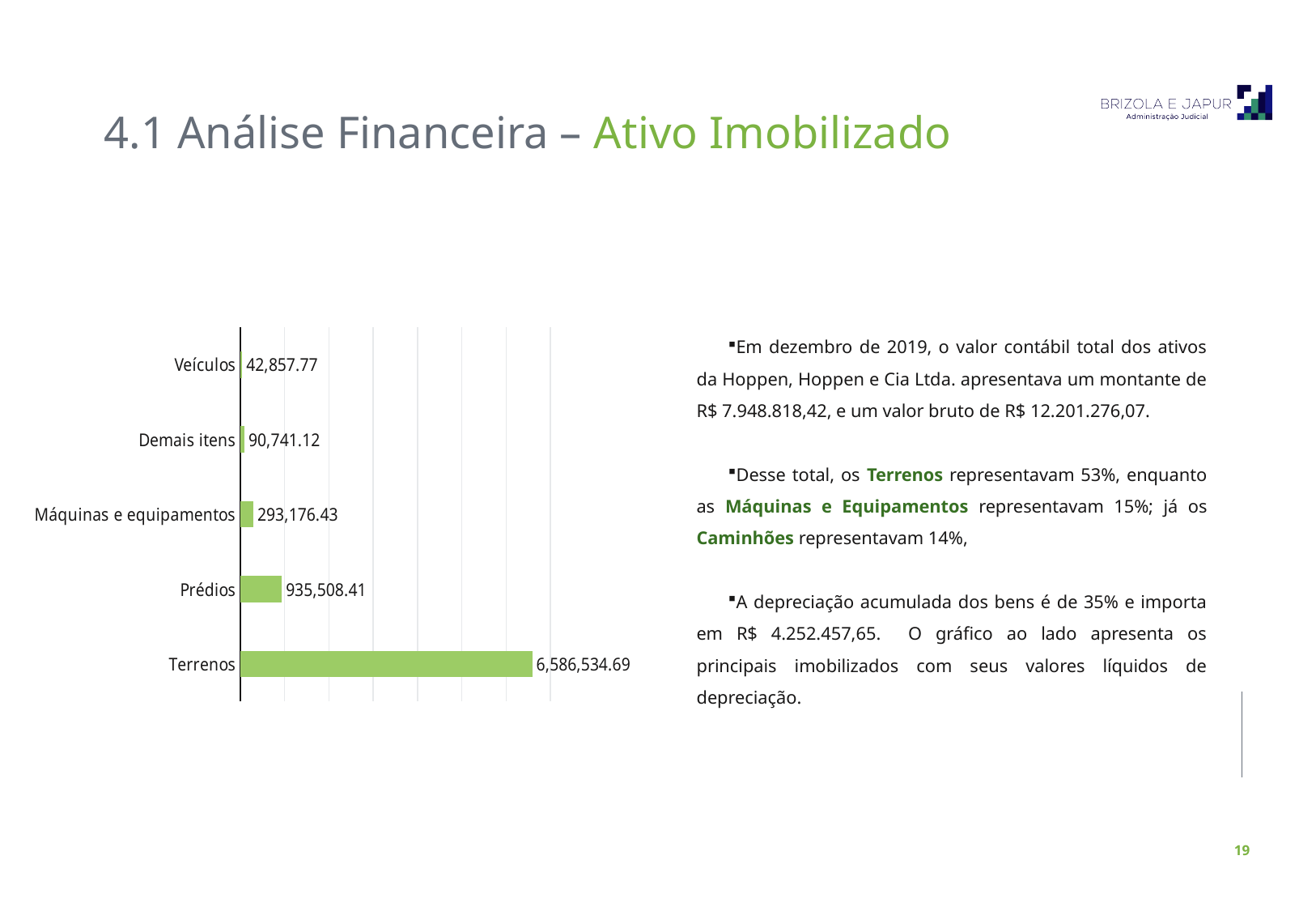
What is the value for Prédios? 935,508.41 What is the value for Demais itens? 90,741.12 What is the value for Máquinas e equipamentos? 293,176.43 What is the difference between the values for Terrenos and Prédios? 5,651,026.28 What is the difference between the values for Prédios and Máquinas e equipamentos? 642,331.98 How many categories are shown in the chart? 5 Which category has the lowest value? Veículos What is the value for Veículos? 42,857.77 What is the value for Terrenos? 6,586,534.69 Which is larger, the value for Demais itens or the value for Veículos? Demais itens What kind of chart is shown on the slide? Bar chart Which category has the highest value? Terrenos